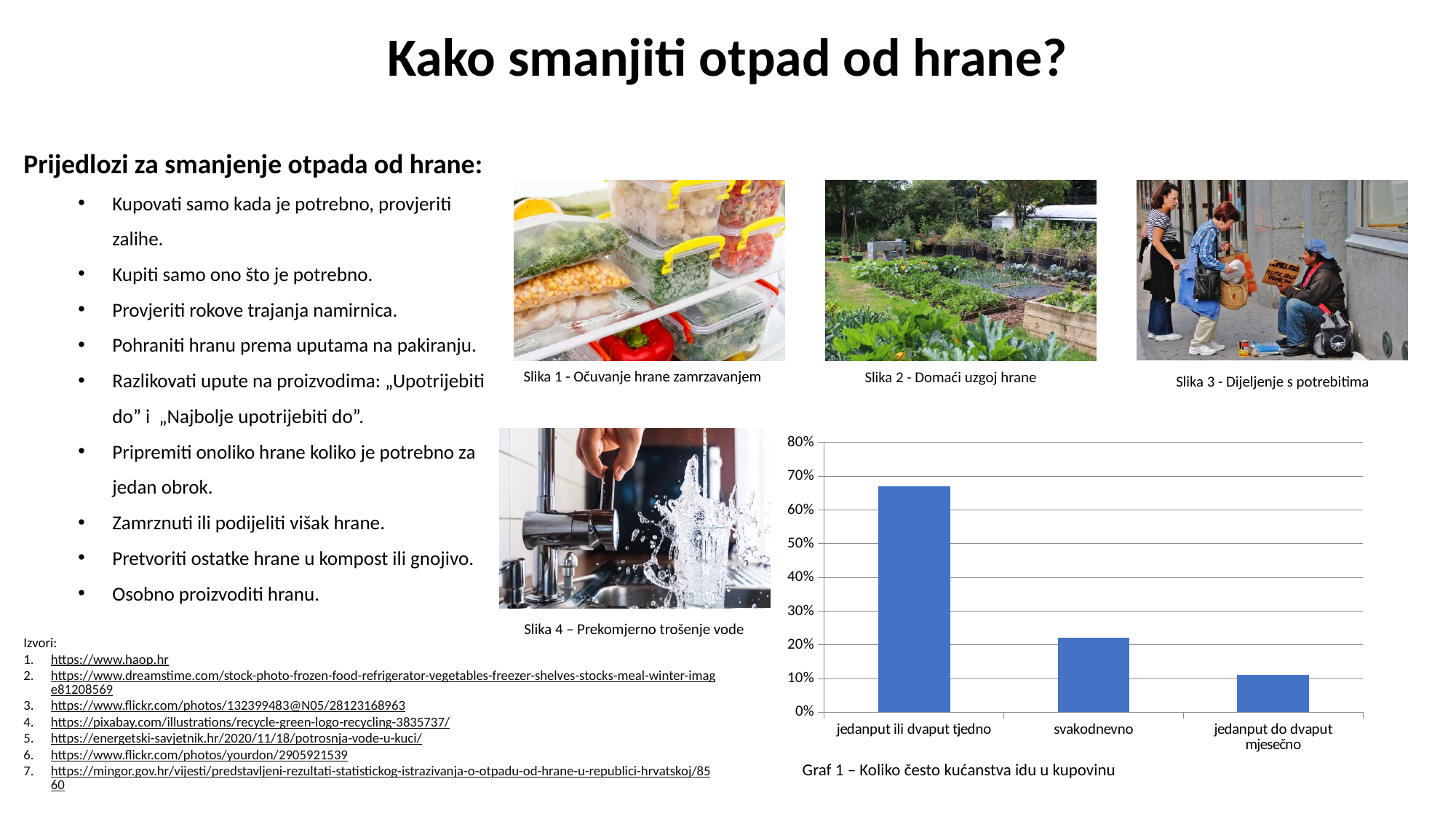
Is the value for 'svakodnevno' greater or less than 20%? greater Do the bar values rise or fall from left to right along the x axis? fall How many categories does the bar chart show? 3 Is the value for 'jedanput ili dvaput tjedno' greater or less than 70%? less Which is larger: the value for 'svakodnevno' or the value for 'jedanput do dvaput mjesečno'? svakodnevno Is the value for 'jedanput do dvaput mjesečno' greater or less than 20%? less Which category has the highest value in the bar chart? jedanput ili dvaput tjedno What kind of chart is shown on the slide? bar chart What is the caption of the bar chart on the slide? Graf 1 – Koliko često kućanstva idu u kupovinu Which category has the lowest value in the bar chart? jedanput do dvaput mjesečno